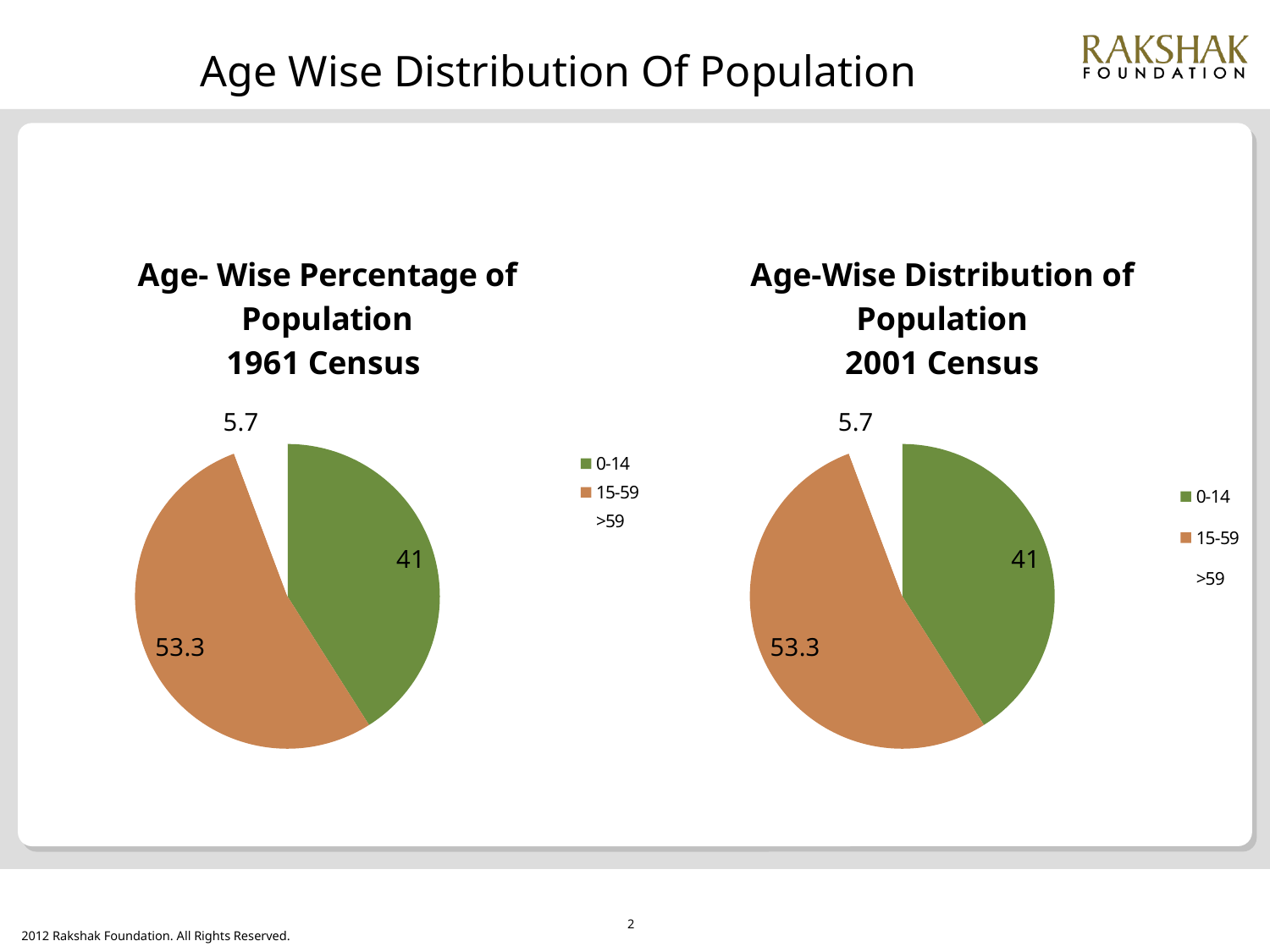
In the 1961 Census pie chart, what colour is the 0-14 slice? Green How many age groups does the legend of the 2001 Census pie chart list? 3 In the 2001 Census pie chart, what is the value for the 0-14 age group? 41 In the 1961 Census pie chart, what is the difference between the 15-59 value and the 0-14 value? 12.3 In the 2001 Census pie chart, which is larger, the 0-14 slice or the >59 slice? 0-14 In the 1961 Census pie chart, which age group has the smallest slice? >59 In the 1961 Census pie chart, what is the value for the 15-59 age group? 53.3 In the 1961 Census pie chart, what is the value for the >59 age group? 5.7 In the 2001 Census pie chart, what is the sum of the three labelled values? 100 In the 2001 Census pie chart, which age group has the largest slice? 15-59 What type of chart is used for the 1961 Census data? Pie chart How many pie charts are shown on the slide? 2